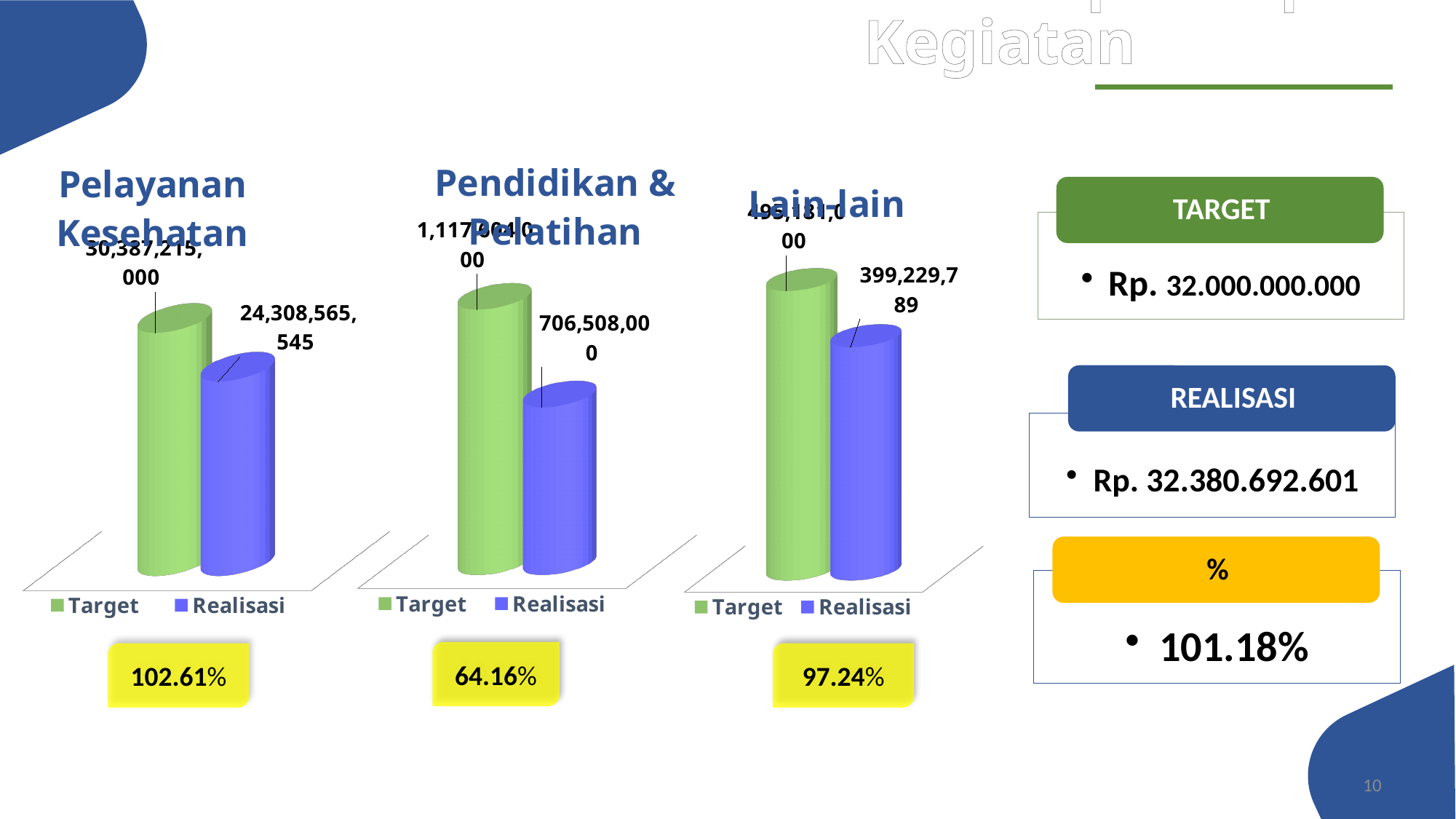
In the Pelayanan Kesehatan chart, which bar is taller, Target or Realisasi? Target In the Pelayanan Kesehatan chart, what is the value of the Realisasi bar? 24,308,565,545 In the Lain-lain chart, which bar is taller, Target or Realisasi? Target What are the two legend entries in the Pendidikan & Pelatihan chart? Target and Realisasi How many charts are shown on the slide? 3 What kind of chart is the Lain-lain chart? Bar chart How many series does the legend of the Pelayanan Kesehatan chart list? 2 In the Pendidikan & Pelatihan chart, which bar is taller, Target or Realisasi? Target In the Pendidikan & Pelatihan chart, what is the value of the Realisasi bar? 706,508,000 Across the three charts, which chart has the lowest Realisasi value? Lain-lain In the Lain-lain chart, what is the value of the Realisasi bar? 399,229,789 Across the three charts, which chart has the highest Realisasi value? Pelayanan Kesehatan